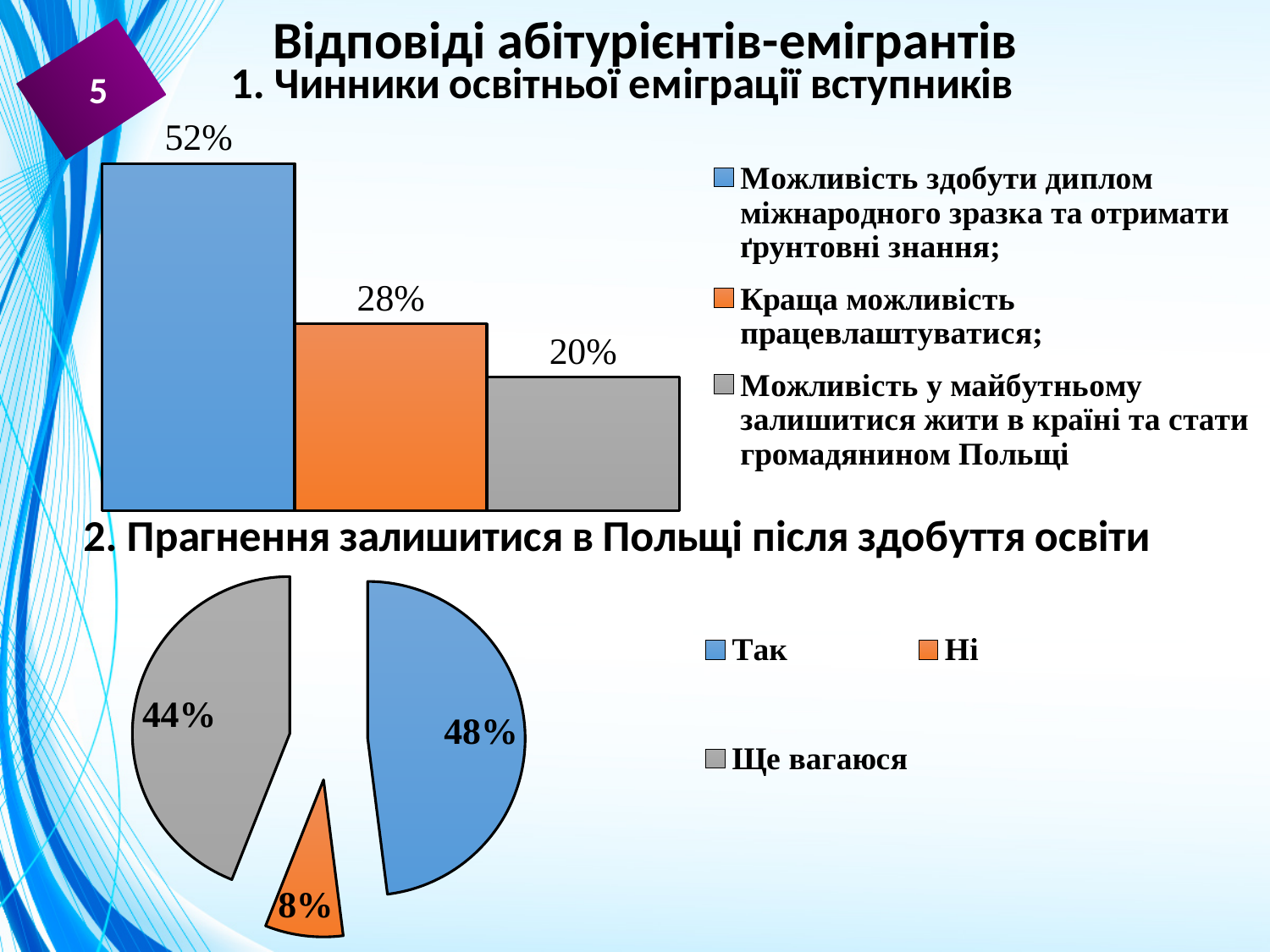
In the top chart (1. Чинники освітньої еміграції вступників), what is the value for "Можливість здобути диплом міжнародного зразка та отримати ґрунтовні знання"? 52% In the bottom chart (2. Прагнення залишитися в Польщі після здобуття освіти), which answer has the smallest slice? Ні In the top chart (1. Чинники освітньої еміграції вступників), which factor has the lowest value? Можливість у майбутньому залишитися жити в країні та стати громадянином Польщі What kind of chart is the top chart (1. Чинники освітньої еміграції вступників)? Bar chart In the top chart (1. Чинники освітньої еміграції вступників), what is the value for "Можливість у майбутньому залишитися жити в країні та стати громадянином Польщі"? 20% In the top chart (1. Чинники освітньої еміграції вступників), what is the difference between the highest and lowest values? 32% In the bottom chart (2. Прагнення залишитися в Польщі після здобуття освіти), what share of respondents answered "Ні"? 8% What kind of chart is the bottom chart (2. Прагнення залишитися в Польщі після здобуття освіти)? Pie chart In the bottom chart (2. Прагнення залишитися в Польщі після здобуття освіти), what share of respondents answered "Так"? 48% How many entries does the legend of the top chart (1. Чинники освітньої еміграції вступників) list? 3 In the top chart (1. Чинники освітньої еміграції вступників), what is the value for "Краща можливість працевлаштуватися"? 28% In the top chart (1. Чинники освітньої еміграції вступників), which factor has the highest value? Можливість здобути диплом міжнародного зразка та отримати ґрунтовні знання